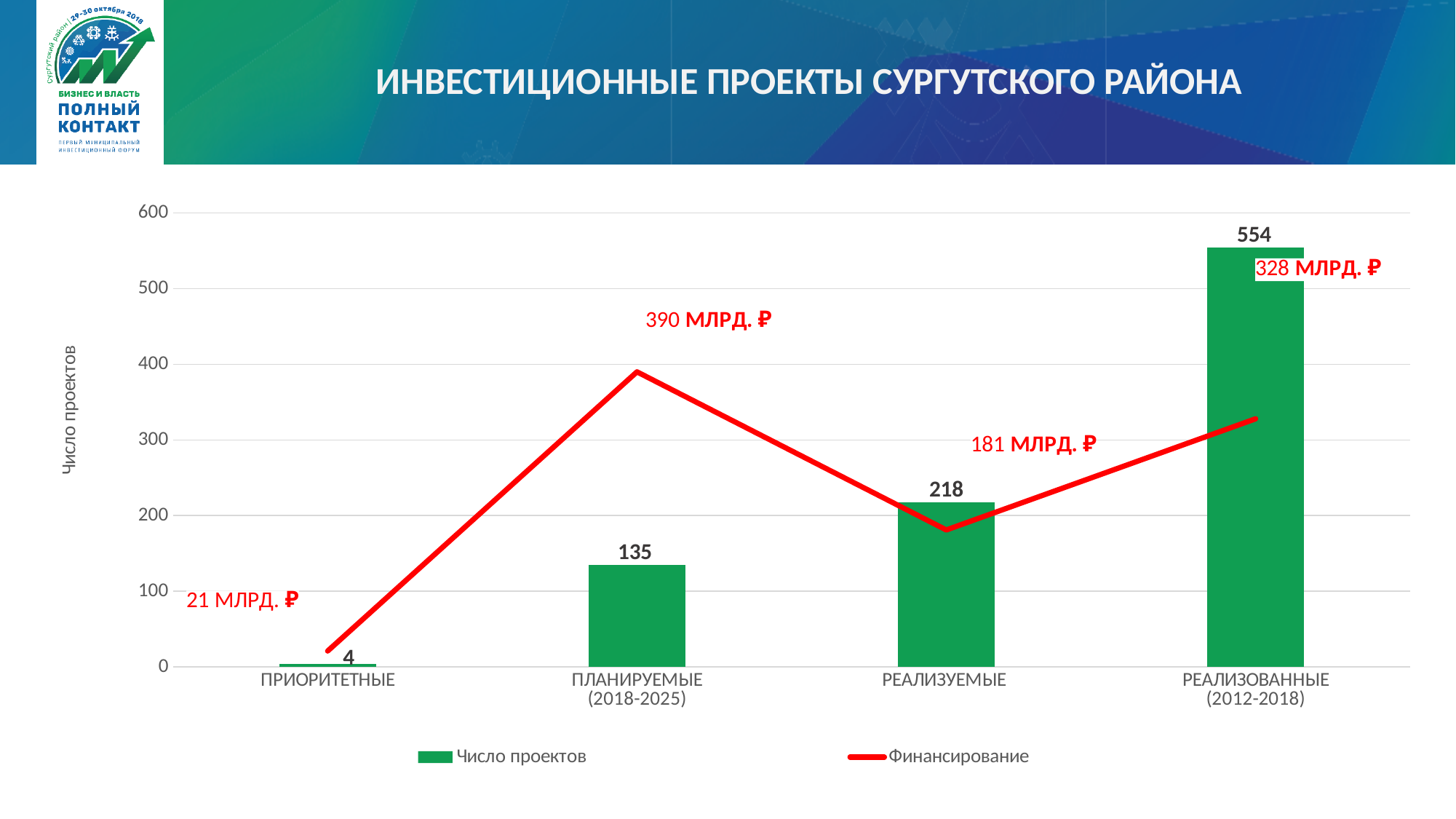
What is the number of projects for the РЕАЛИЗОВАННЫЕ (2012-2018) category? 554 What is the difference in the number of projects between РЕАЛИЗОВАННЫЕ (2012-2018) and РЕАЛИЗУЕМЫЕ? 336 Which is larger: the Финансирование for РЕАЛИЗУЕМЫЕ or for РЕАЛИЗОВАННЫЕ (2012-2018)? РЕАЛИЗОВАННЫЕ (2012-2018) What is the Финансирование value shown for the ПЛАНИРУЕМЫЕ (2018-2025) category? 390 МЛРД. ₽ Which category has the lowest number of projects? ПРИОРИТЕТНЫЕ How many categories are shown on the x axis of the chart? 4 Which category has the highest Финансирование value? ПЛАНИРУЕМЫЕ (2018-2025) Which category has the highest number of projects? РЕАЛИЗОВАННЫЕ (2012-2018) How many series does the chart legend list? 2 What is the Финансирование value shown for the ПРИОРИТЕТНЫЕ category? 21 МЛРД. ₽ What is the title of the y axis of the chart? Число проектов What is the number of projects (Число проектов) for the ПЛАНИРУЕМЫЕ (2018-2025) category? 135